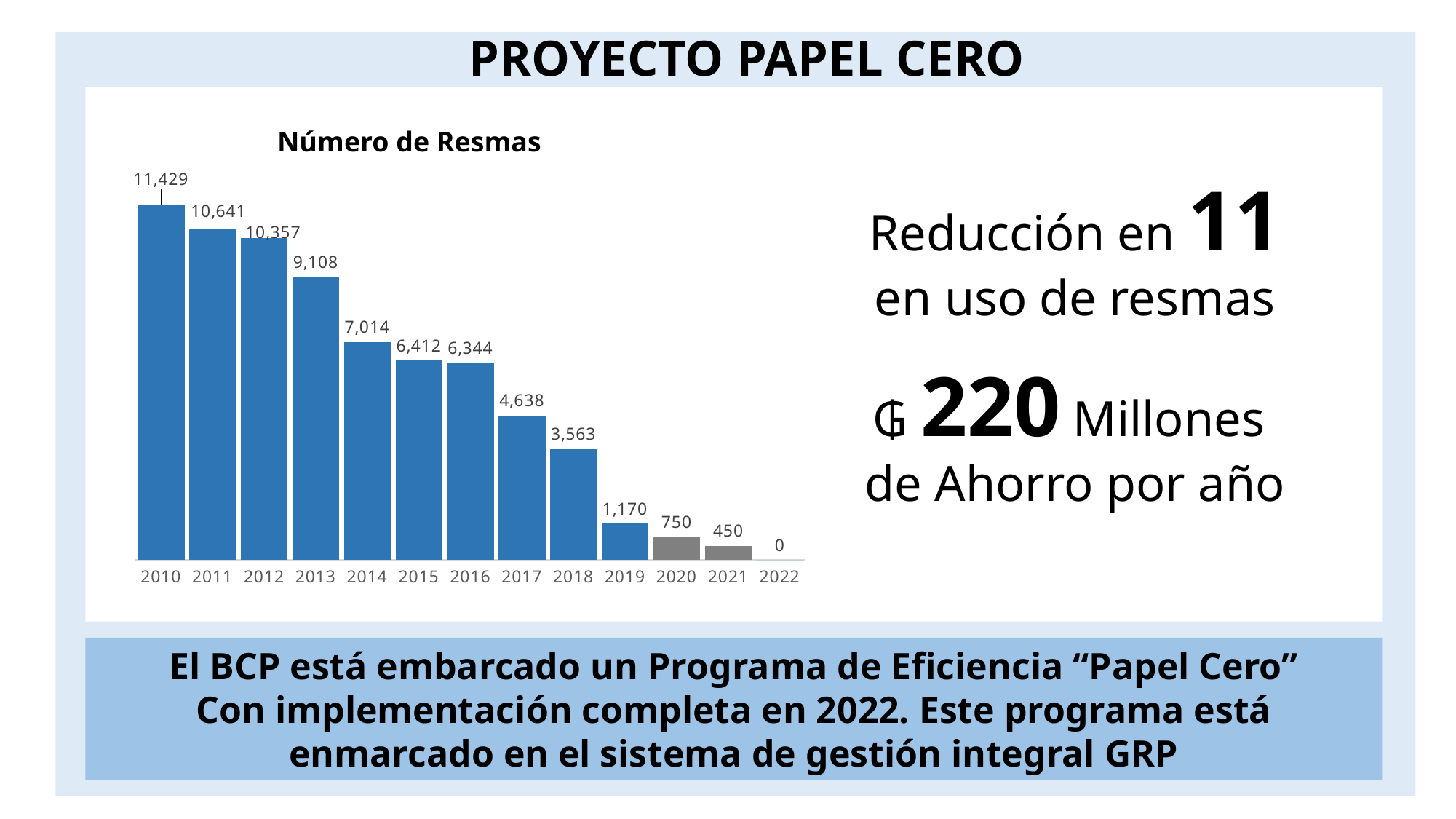
Which year has the highest number of resmas? 2010 What is the value for 2017 in the Número de Resmas chart? 4,638 Which is larger, the value for 2015 or the value for 2016? 2015 Which year has the lowest number of resmas? 2022 How many years are shown on the x axis of the chart? 13 What is the difference between the values for 2010 and 2011? 788 What is the value for 2010 in the Número de Resmas chart? 11,429 What is the difference between the values for 2018 and 2019? 2,393 What is the title of the chart? Número de Resmas What is the value for 2020 in the Número de Resmas chart? 750 Do the values rise or fall from 2010 to 2022? Fall What kind of chart is shown on the slide? Bar chart